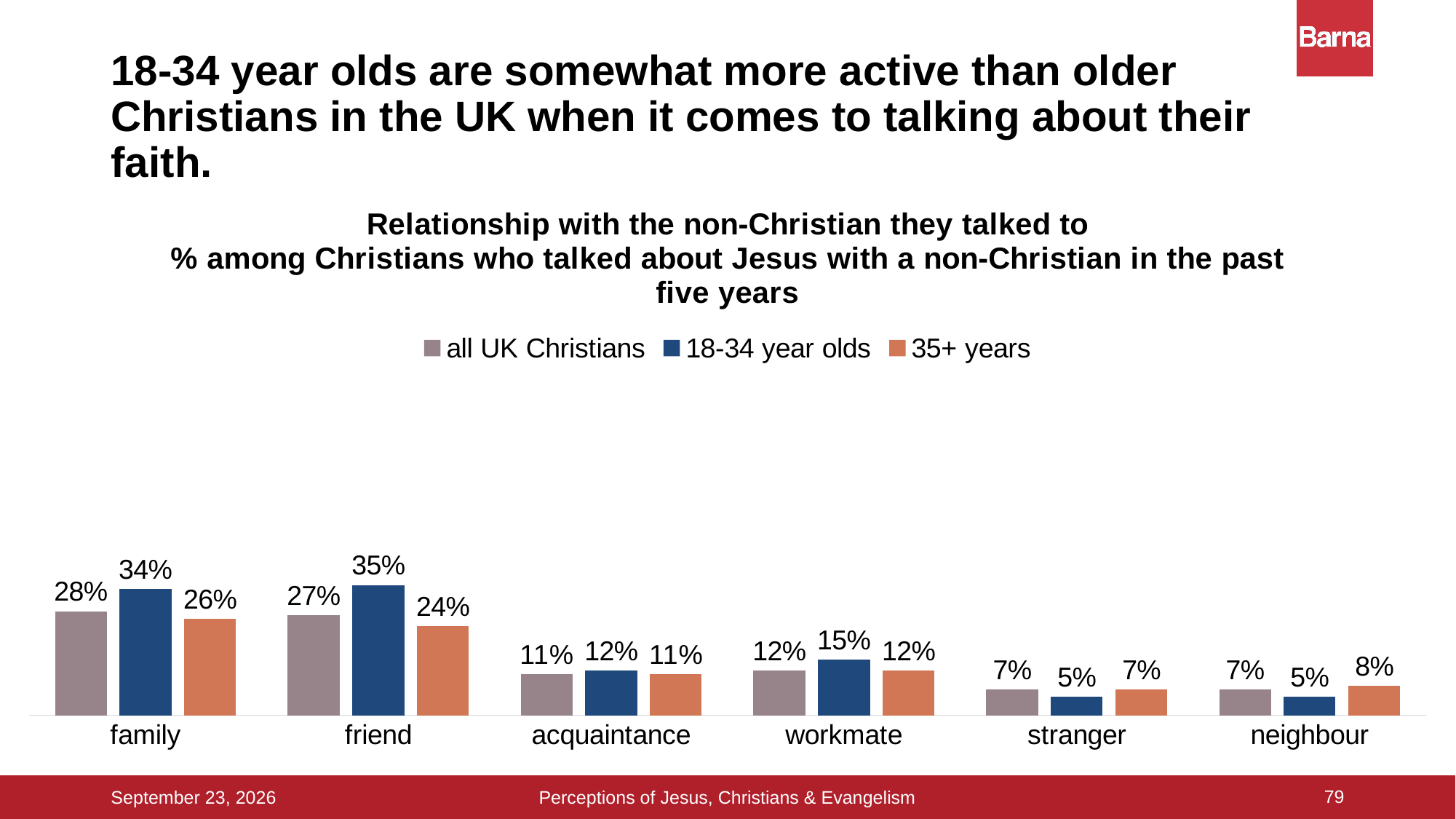
What percentage of 18-34 year olds talked to a family member? 34% Which series is shown in orange in the legend? 35+ years How many series does the legend list? 3 Which is larger for the workmate category: 18-34 year olds or 35+ years? 18-34 year olds What is the difference between 18-34 year olds and 35+ years in the friend category? 11 percentage points Which category has the highest value for 18-34 year olds? friend What is the difference between all UK Christians and 35+ years in the family category? 2 percentage points What is the value for all UK Christians in the friend category? 27% What percentage of 35+ years talked to a neighbour? 8% Which category has the lowest value for all UK Christians? stranger and neighbour (both 7%) What kind of chart is shown on the slide? bar chart How many relationship categories are shown on the x axis? 6